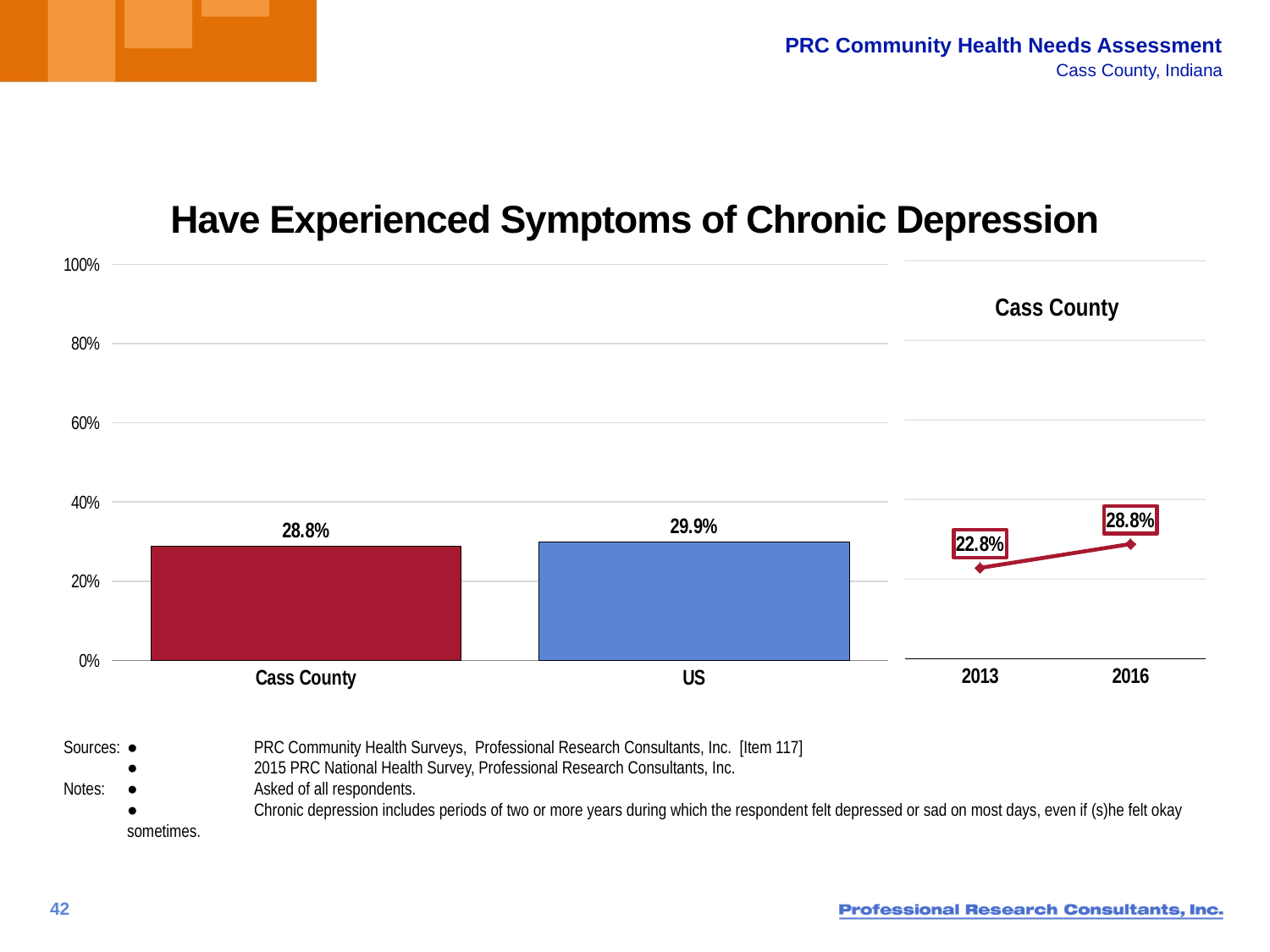
In the bar chart on the left, what is the value for Cass County? 28.8% In the Cass County trend chart on the right, what is the value for 2016? 28.8% In the bar chart on the left, what is the difference between the US value and the Cass County value? 1.1% In the Cass County trend chart on the right, what is the difference between the 2016 value and the 2013 value? 6.0% What kind of chart is the chart on the left of the slide? bar chart In the Cass County trend chart on the right, did the value rise or fall from 2013 to 2016? rise In the bar chart on the left, is the value for Cass County greater or less than 40%? less In the Cass County trend chart on the right, what is the value for 2013? 22.8% In the bar chart on the left, what is the value for US? 29.9% How many bars are shown in the bar chart on the left? 2 In the bar chart on the left, which category has the higher value, Cass County or US? US What is the title of the chart on the slide? Have Experienced Symptoms of Chronic Depression